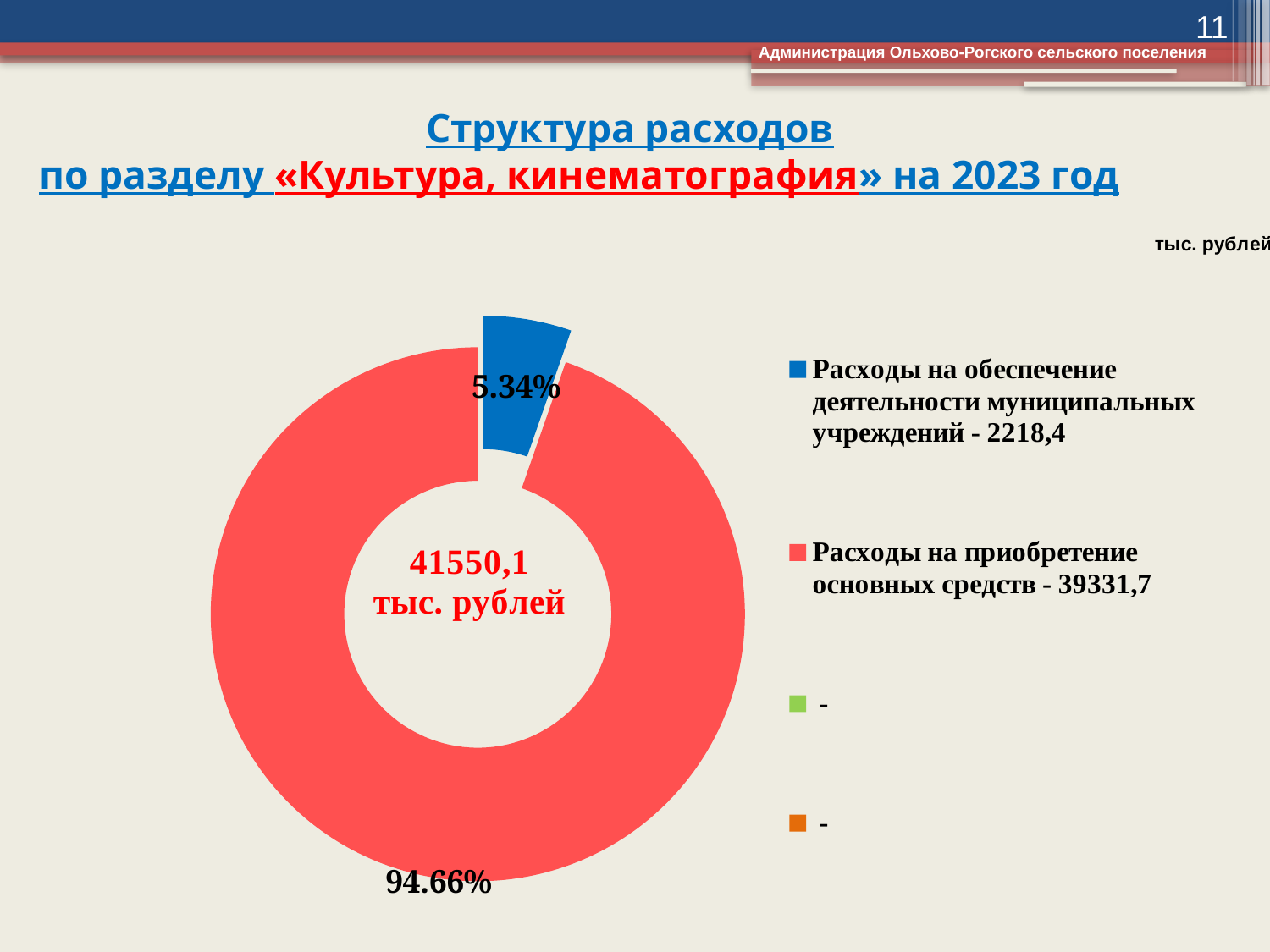
What value (тыс. рублей) is given in the legend for «Расходы на обеспечение деятельности муниципальных учреждений»? 2218,4 What total amount is shown in the centre of the doughnut chart? 41550,1 тыс. рублей What colour is the slice for «Расходы на обеспечение деятельности муниципальных учреждений»? blue What share of the chart does the slice for «Расходы на приобретение основных средств» represent? 94.66% What share of the chart does the slice for «Расходы на обеспечение деятельности муниципальных учреждений» represent? 5.34% What value (тыс. рублей) is given in the legend for «Расходы на приобретение основных средств»? 39331,7 What is the difference between the values for «Расходы на приобретение основных средств» and «Расходы на обеспечение деятельности муниципальных учреждений»? 37113,3 Which category has the smallest slice of the chart? Расходы на обеспечение деятельности муниципальных учреждений Which is larger: the value for «Расходы на приобретение основных средств» or for «Расходы на обеспечение деятельности муниципальных учреждений»? Расходы на приобретение основных средств Which category has the largest slice of the chart? Расходы на приобретение основных средств What kind of chart is shown on the slide? doughnut (pie) chart How many slices with data are shown in the doughnut chart? 2